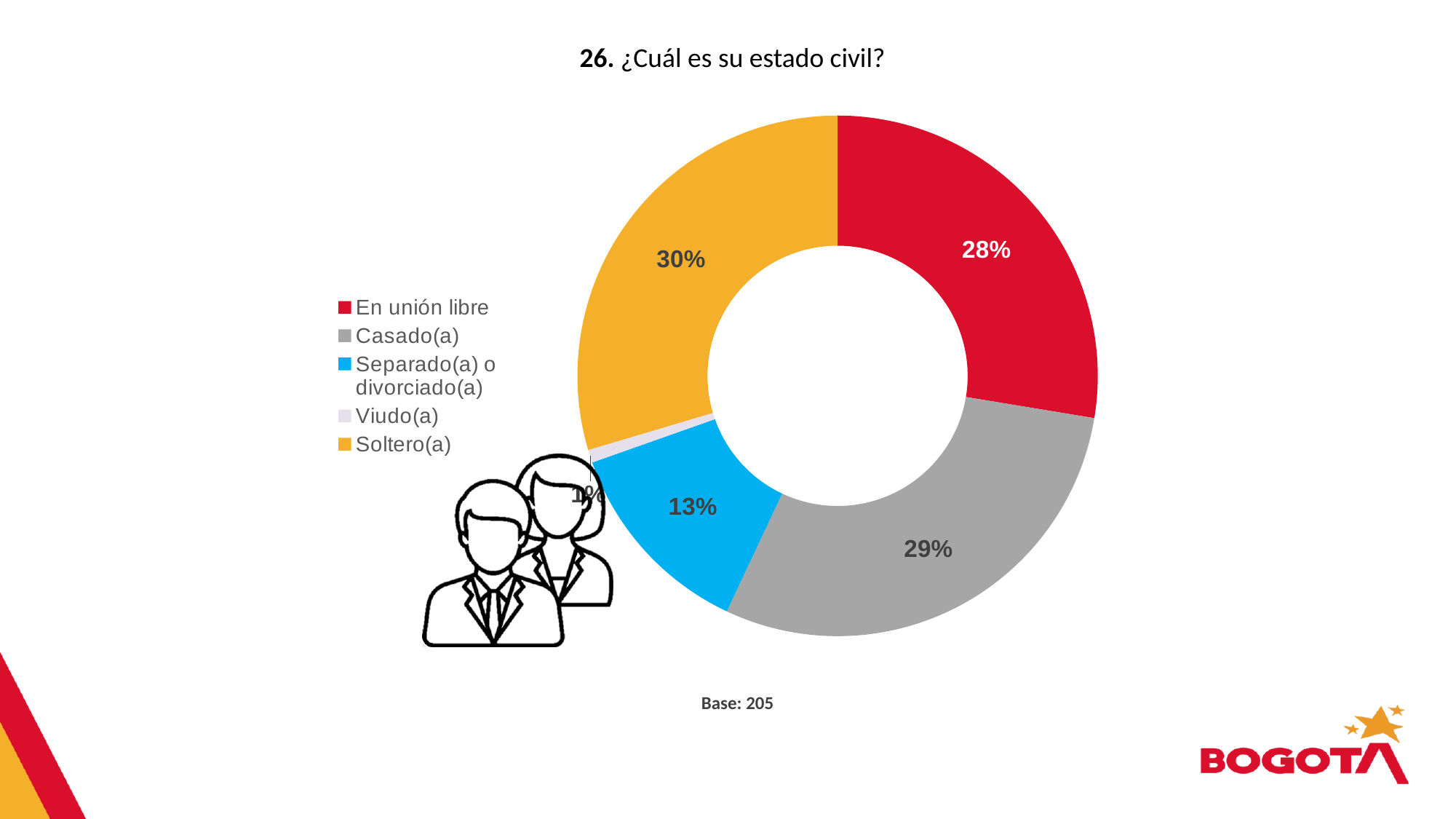
Which marital status has the smallest share in the chart? Viudo(a) How many categories does the legend list? 5 What percentage of respondents answered "Separado(a) o divorciado(a)"? 13% What percentage of respondents answered "Casado(a)"? 29% What is the difference in percentage points between "Soltero(a)" and "Separado(a) o divorciado(a)"? 17 What percentage of respondents answered "Soltero(a)"? 30% Which marital status has the largest share in the chart? Soltero(a) What is the base (number of respondents) shown below the chart? 205 Which is larger, the share for "Casado(a)" or the share for "En unión libre"? Casado(a) What colour represents "Separado(a) o divorciado(a)" in the chart? Blue What kind of chart is shown on the slide? Pie chart (donut) What percentage of respondents answered "En unión libre"? 28%